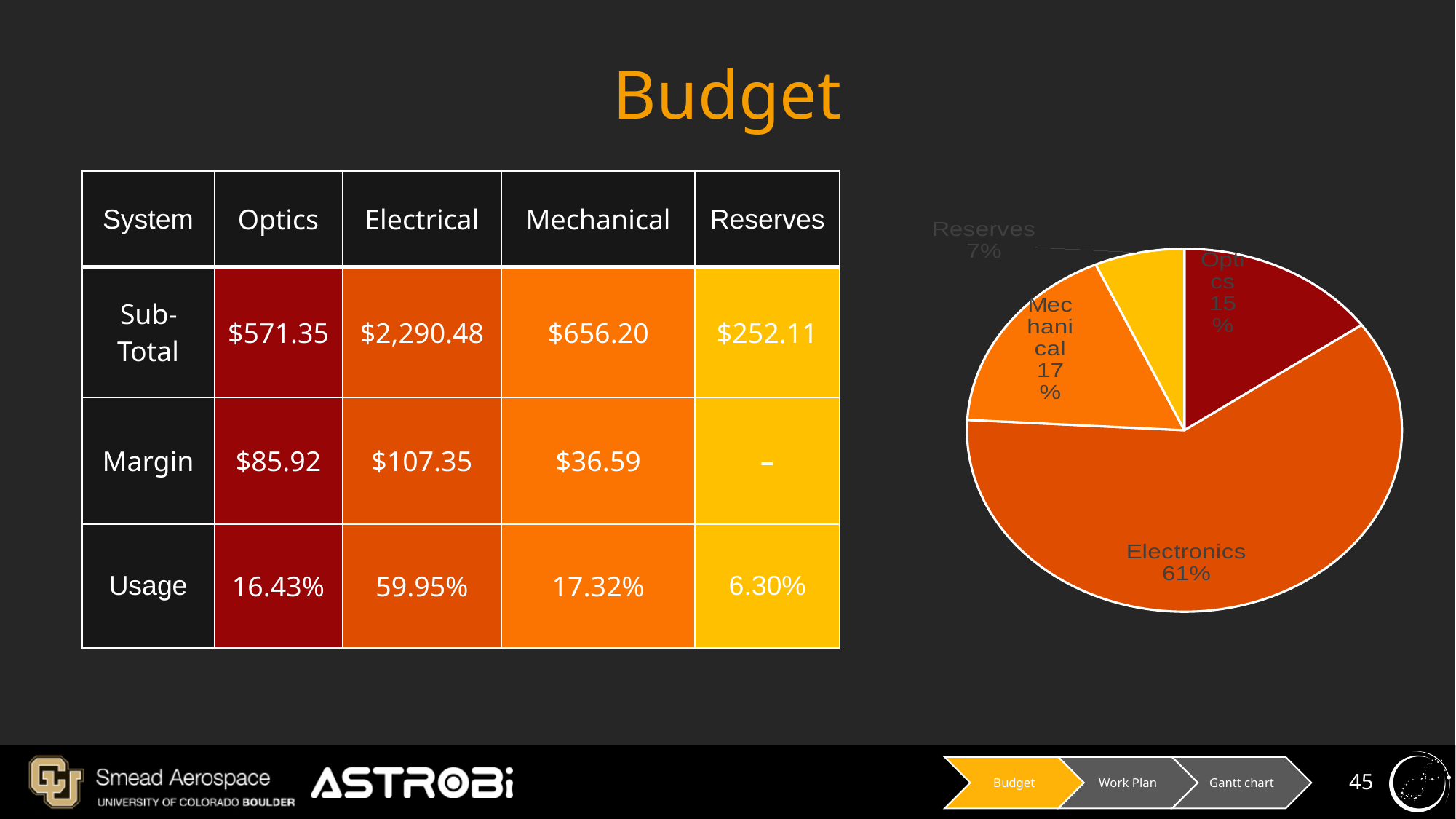
What kind of chart is shown on the slide? pie chart What percentage of the pie chart is Electronics? 61% In the pie chart, which is larger, Mechanical or Optics? Mechanical In the pie chart, what is the difference in percentage points between Electronics and Mechanical? 44 In the pie chart, what is the difference in percentage points between Optics and Reserves? 8 Which slice of the pie chart is the largest? Electronics What percentage of the pie chart is Optics? 15% What percentage of the pie chart is Reserves? 7% How many slices does the pie chart have? 4 What percentage of the pie chart is Mechanical? 17% Which slice of the pie chart is the smallest? Reserves What colour is the Electronics slice in the pie chart? orange-red